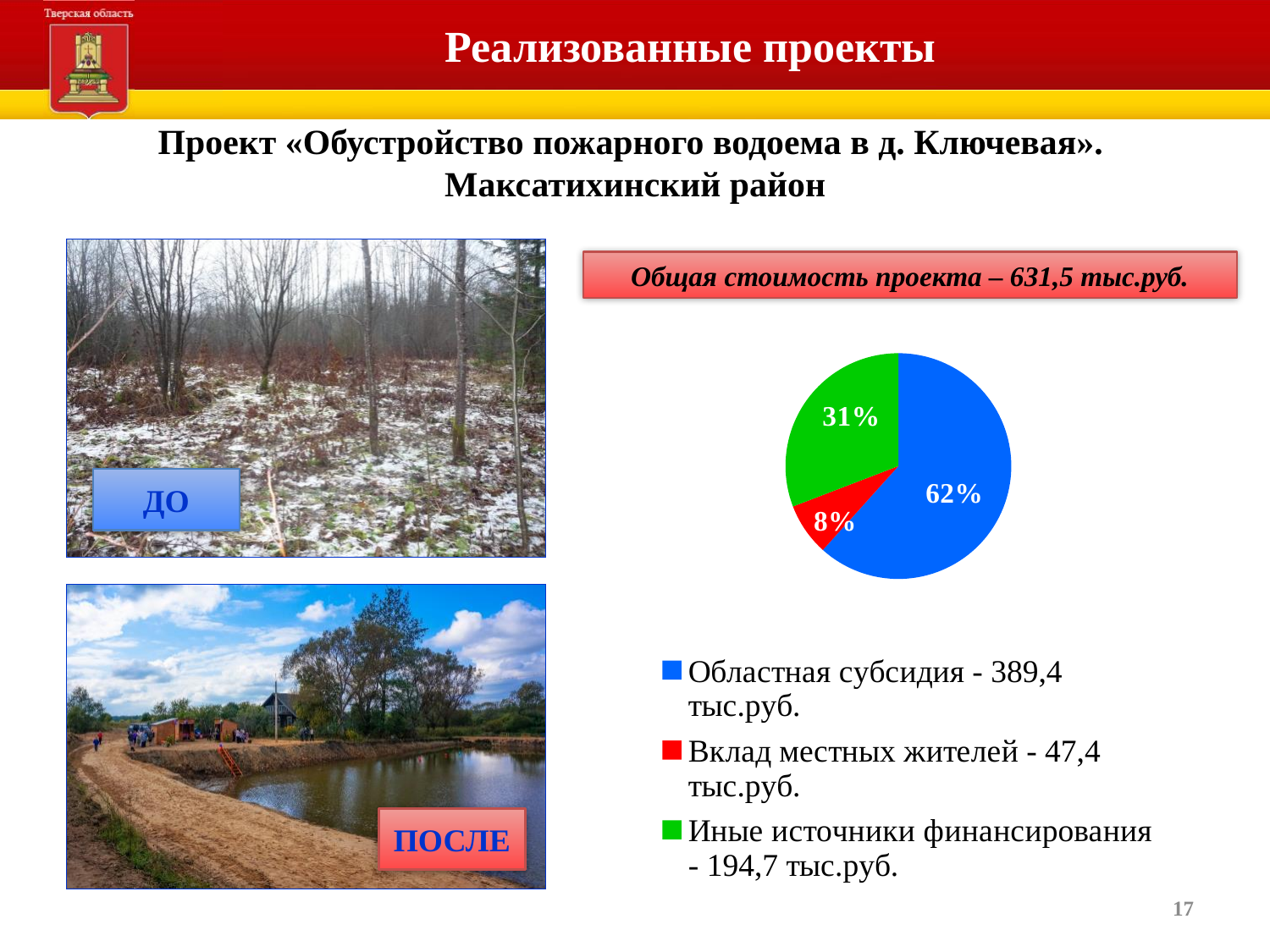
What share of the pie does "Иные источники финансирования" take? 31% Which funding source has the smallest slice of the pie? Вклад местных жителей What share of the pie does "Вклад местных жителей" take? 8% Which funding source has the largest slice of the pie? Областная субсидия What colour is the slice for "Иные источники финансирования"? green What amount does the legend give for "Вклад местных жителей"? 47,4 тыс.руб. How many entries does the legend of the pie chart list? 3 How many slices does the pie chart have? 3 What kind of chart is shown on the slide? pie chart By how many percentage points does the "Областная субсидия" share exceed the "Иные источники финансирования" share? 31 Which is larger: the share for "Иные источники финансирования" or the share for "Вклад местных жителей"? Иные источники финансирования What share of the pie does "Областная субсидия" take? 62%